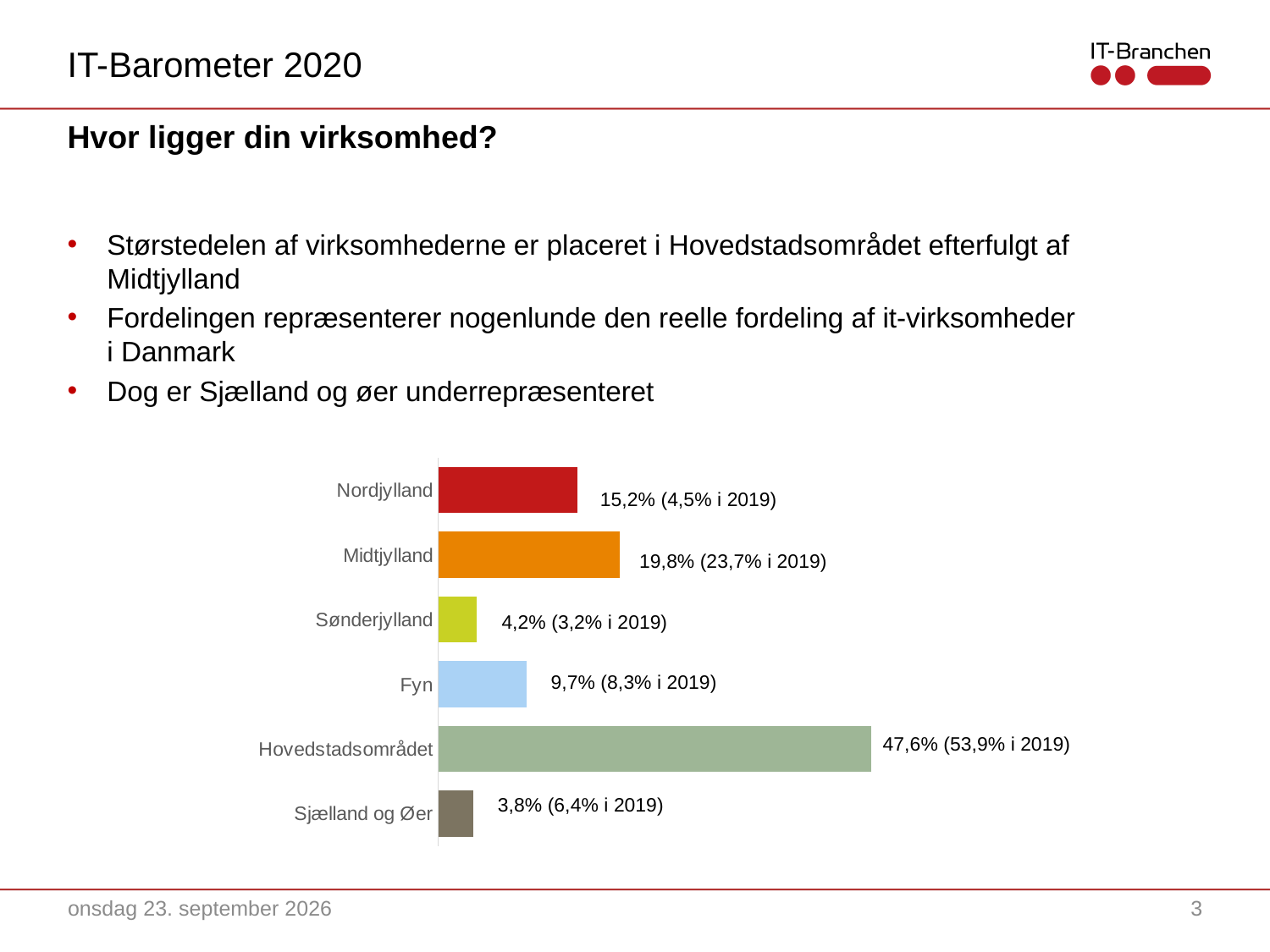
What is the difference between the 2020 values for Hovedstadsområdet and Midtjylland? 27,8 percentage points Which region has the lowest 2020 value? Sjælland og Øer Which region has the highest 2020 value? Hovedstadsområdet By how much did Nordjylland's value increase from 2019 to 2020? 10,7 percentage points How many regions are plotted in the chart? 6 Which has a larger 2020 value, Nordjylland or Midtjylland? Midtjylland What is the 2020 value for Fyn? 9,7% What colour is the bar for Hovedstadsområdet? Grey-green What was the value for Nordjylland in 2019, according to the data label? 4,5% What kind of chart is shown on the slide? Bar chart What is the 2020 value for Midtjylland? 19,8% What is the 2020 value for Hovedstadsområdet? 47,6%